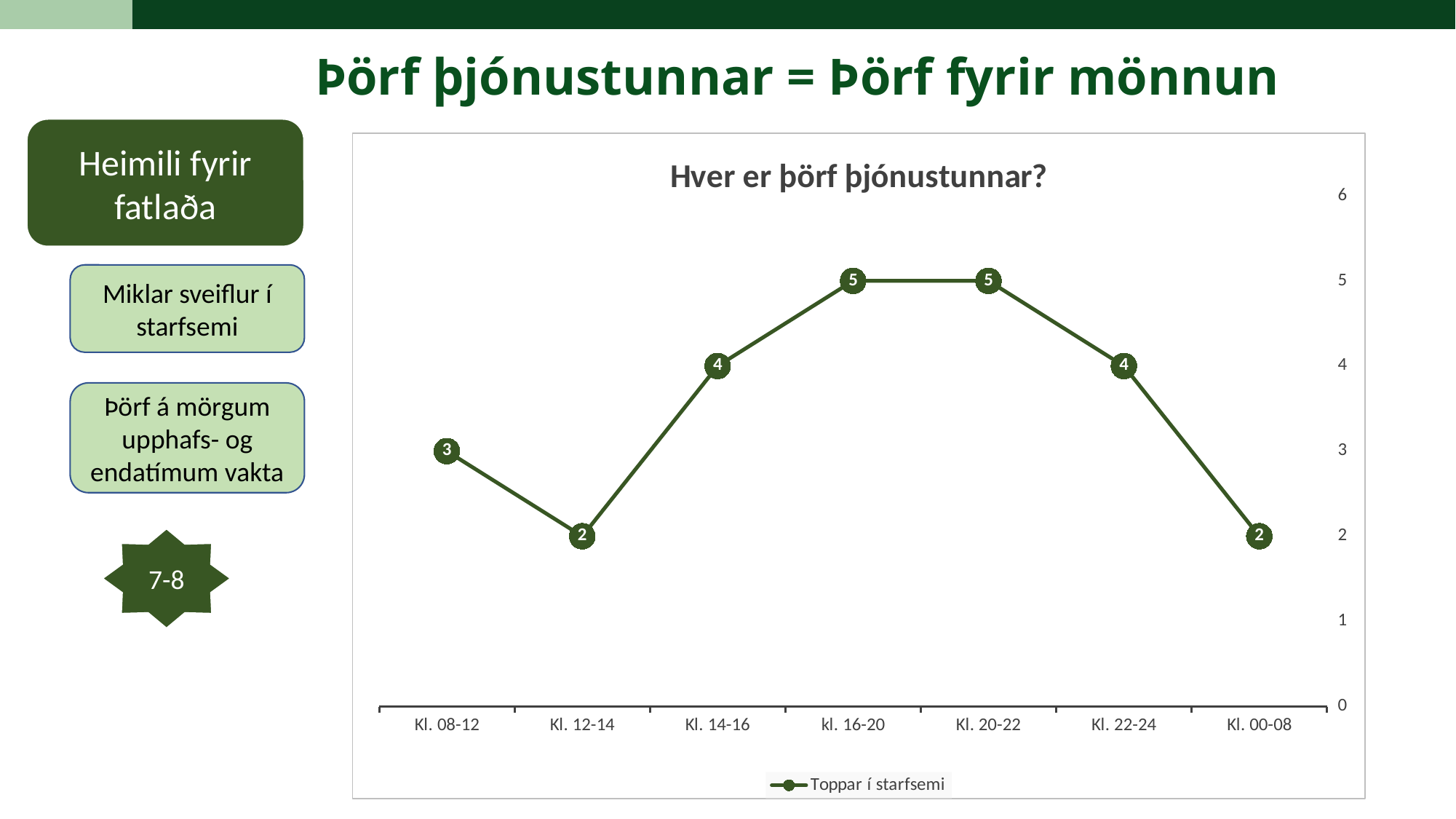
Is the value for kl. 16-20 greater or less than 4? greater Which time slots have the highest value? kl. 16-20 and Kl. 20-22 How many time slots are shown on the x axis? 7 What is the value for Kl. 00-08? 2 What is the value for Kl. 14-16? 4 Which is larger, the value for Kl. 08-12 or the value for Kl. 12-14? Kl. 08-12 What is the title of the chart? Hver er þörf þjónustunnar? How many series does the legend list? 1 What kind of chart is shown? line chart What is the value for Kl. 08-12? 3 What is the difference between the values for Kl. 20-22 and Kl. 22-24? 1 What is the lowest value plotted on the chart? 2